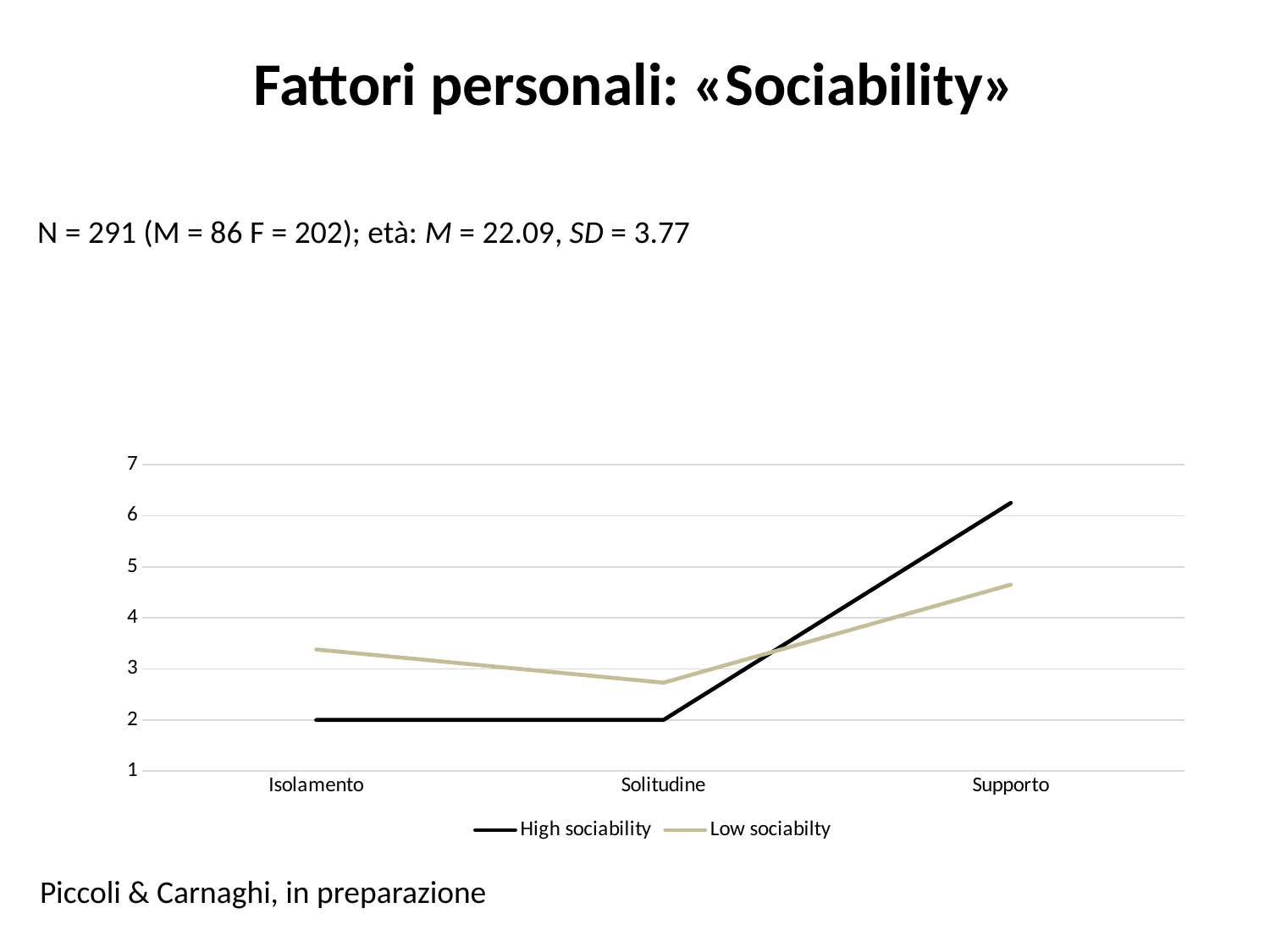
At Supporto, which series has the larger value, High sociability or Low sociabilty? High sociability Which category has the highest value for High sociability? Supporto Which category has the lowest value for Low sociabilty? Solitudine How many categories are shown on the x axis? 3 Which category has the highest value for Low sociabilty? Supporto Is the value for High sociability at Supporto greater or less than 5? greater At Isolamento, which series has the larger value, High sociability or Low sociabilty? Low sociabilty Does the High sociability line rise or fall from Solitudine to Supporto? rise How many series does the legend list? 2 Is the value for Low sociabilty at Isolamento greater or less than 3? greater Is the value for Low sociabilty at Supporto greater or less than 5? less What kind of chart is shown on the slide? line chart